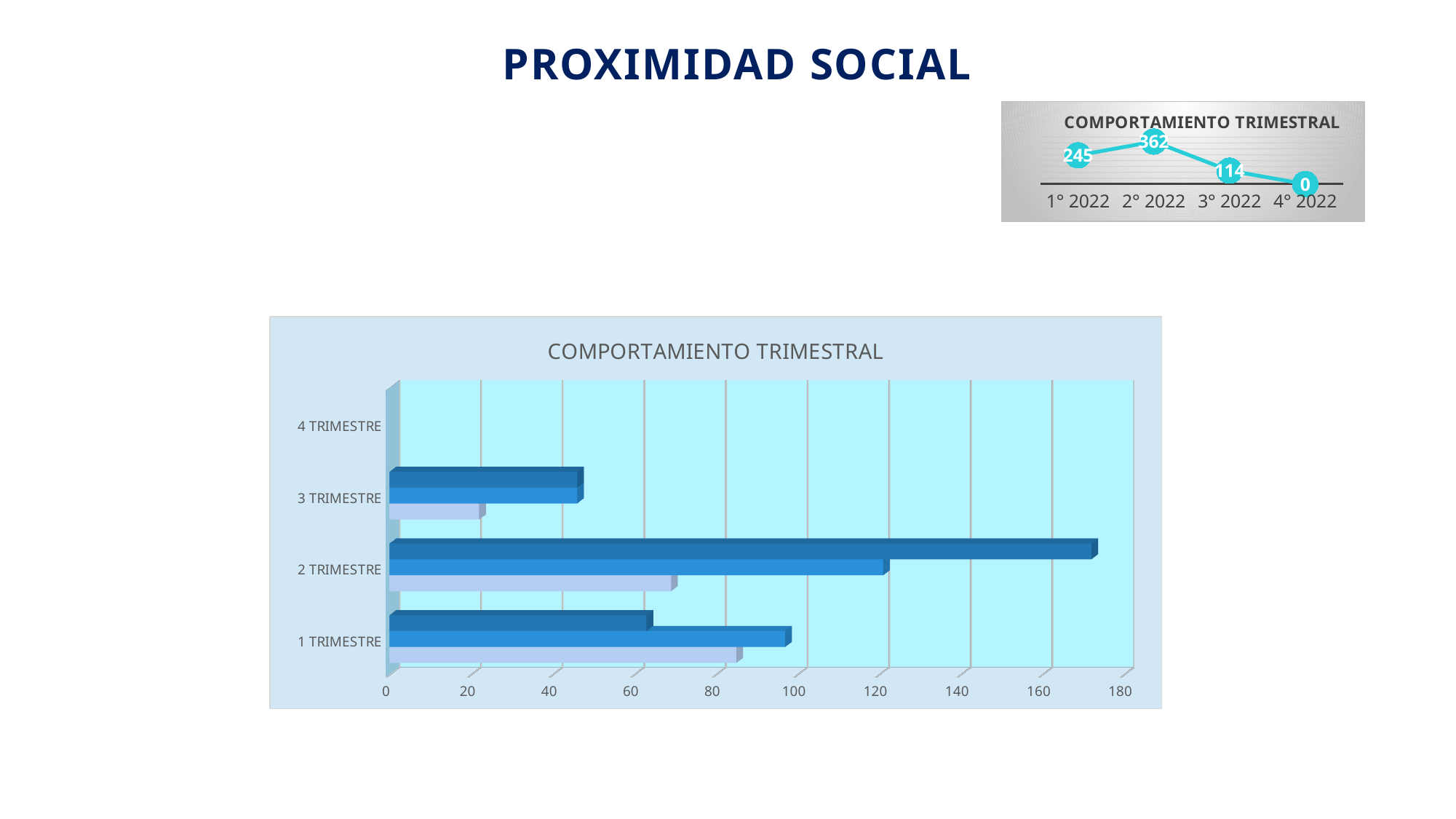
In the line chart at the top right, what is the value for 4° 2022? 0 In the line chart at the top right, what is the value for 2° 2022? 362 In the line chart at the top right, which quarter has the lowest value? 4° 2022 What kind of chart is the large chart at the bottom of the slide? bar chart In the line chart at the top right, what is the value for 3° 2022? 114 In the line chart at the top right, what is the value for 1° 2022? 245 In the bar chart at the bottom, how many categories are shown on the vertical axis? 4 In the line chart at the top right, what is the difference between the values for 2° 2022 and 3° 2022? 248 In the bar chart at the bottom, is the longest bar for 2 TRIMESTRE greater or less than 160? greater In the line chart at the top right, how many data points are plotted? 4 In the line chart at the top right, which quarter has the highest value? 2° 2022 In the line chart at the top right, do the values rise or fall from 2° 2022 to 4° 2022? fall